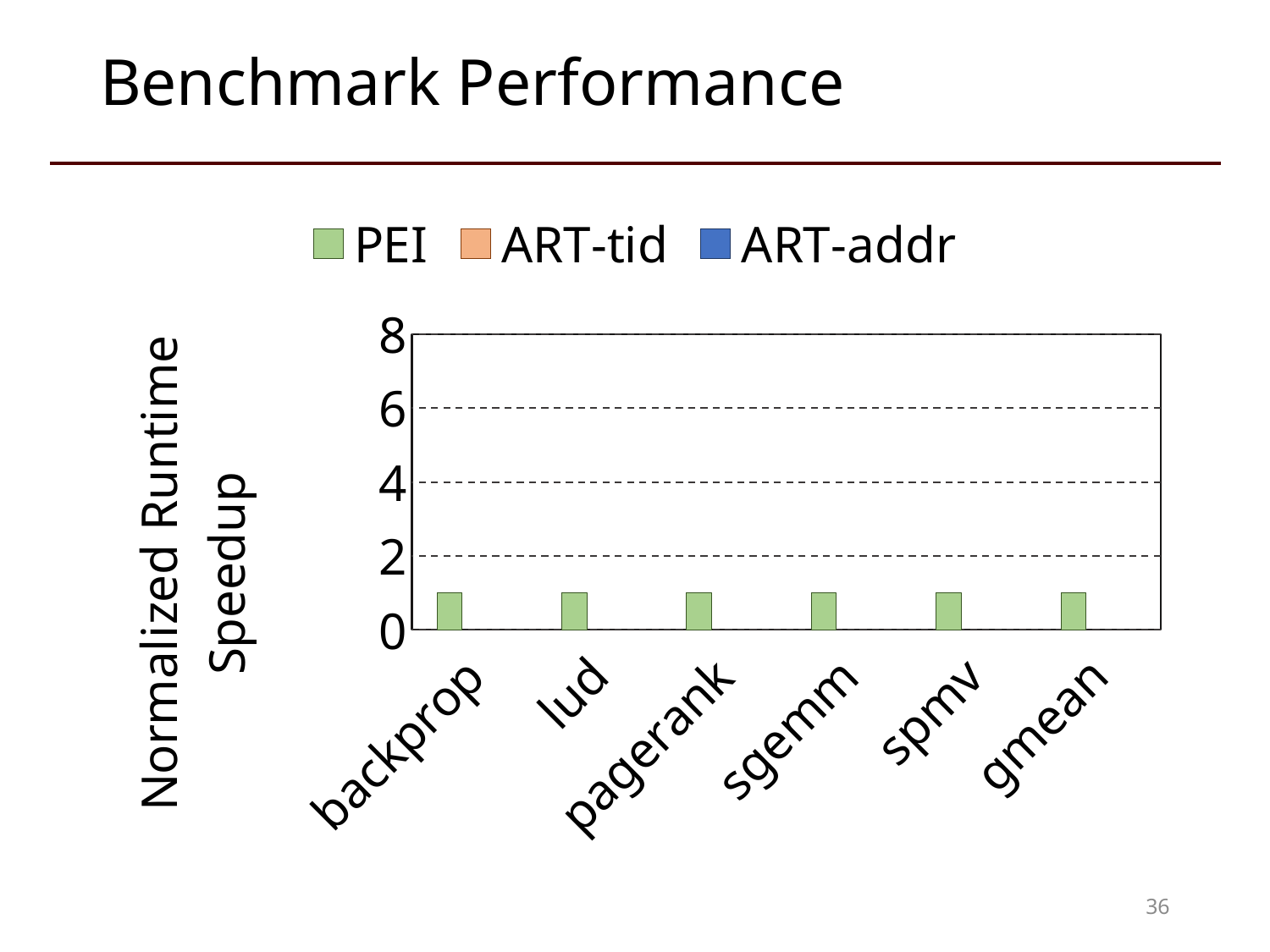
What is the highest value shown on the y axis? 8 Is the PEI value for lud greater or less than 2? less Is the PEI value for spmv greater or less than 2? less What is the label on the y axis of the chart? Normalized Runtime Speedup What is the title of the slide containing the chart? Benchmark Performance How many benchmark categories are shown on the x axis? 6 Is the PEI value for backprop greater or less than 2? less What kind of chart is shown on the slide? bar chart How many series does the legend list? 3